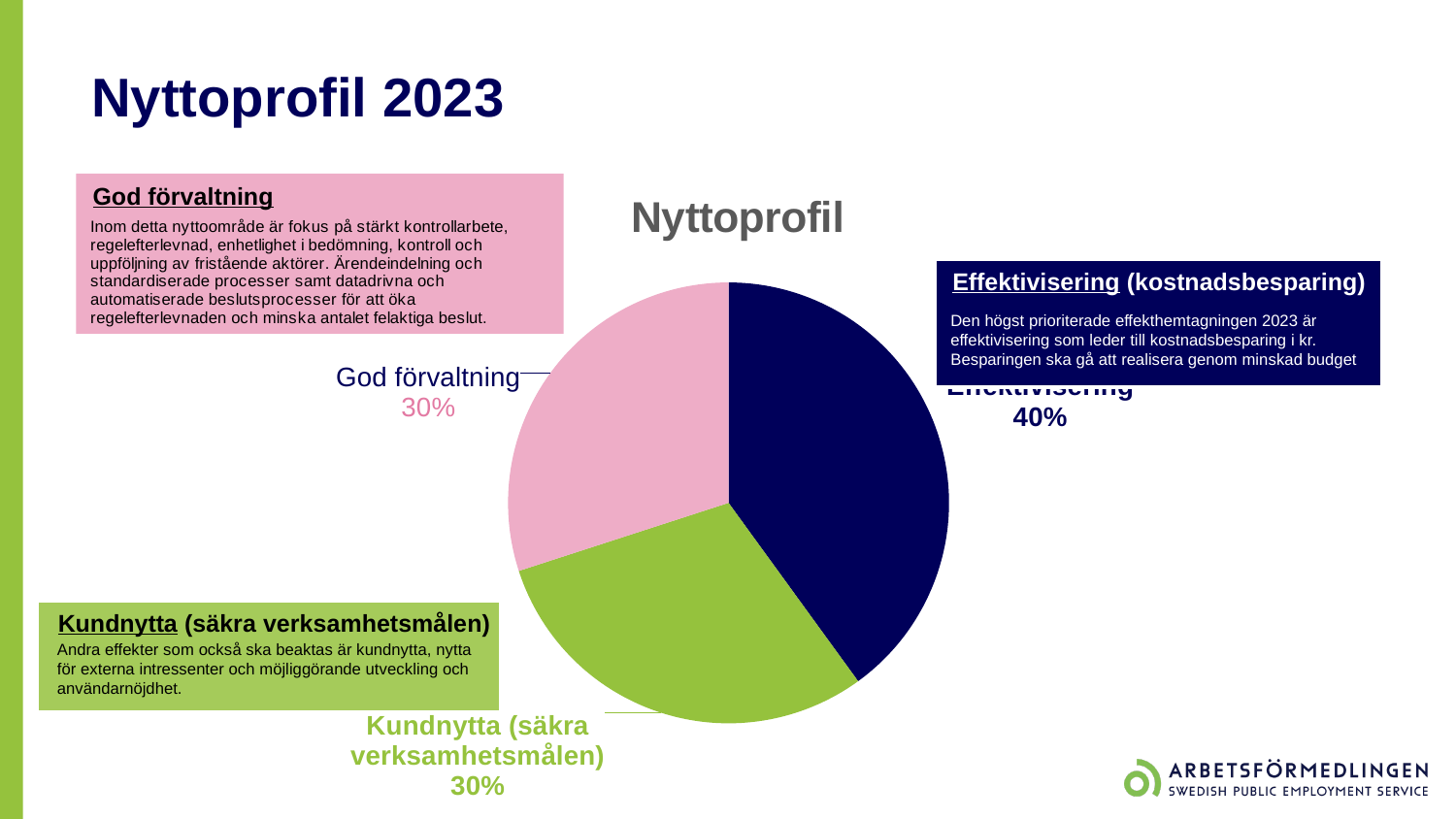
Is the share for Effektivisering greater or less than 50%? less What is the difference in percentage points between Effektivisering and God förvaltning? 10 Which slice of the pie chart is the largest? Effektivisering What colour is the God förvaltning slice? pink What share of the pie does God förvaltning have? 30% What kind of chart is shown on the slide? pie chart What share of the pie does Effektivisering have? 40% What share of the pie does Kundnytta (säkra verksamhetsmålen) have? 30% What is the title of the chart? Nyttoprofil What is the combined share of God förvaltning and Kundnytta (säkra verksamhetsmålen)? 60% Which is larger, the share for Effektivisering or the share for Kundnytta (säkra verksamhetsmålen)? Effektivisering How many slices does the pie chart have? 3